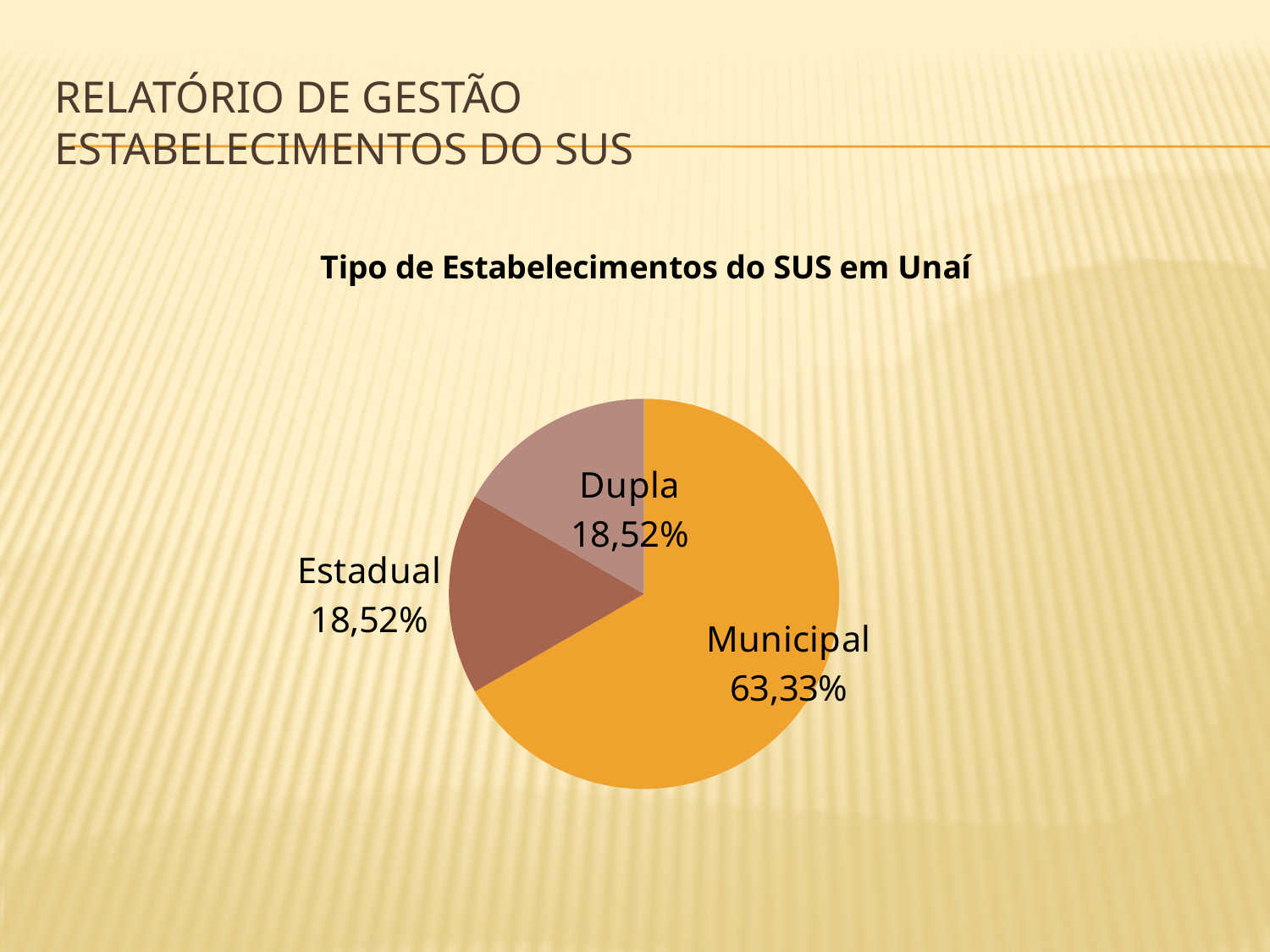
What is the value shown for Estadual? 18,52% What is the title of the chart? Tipo de Estabelecimentos do SUS em Unaí How many slices does the pie chart have? 3 What is the difference between the Municipal and Estadual shares? 44,81% Which slice of the pie is coloured orange? Municipal What is the difference between the Estadual and Dupla shares? 0% What is the value shown for Dupla? 18,52% What kind of chart is shown on the slide? Pie chart Which category has the largest slice of the pie? Municipal Which is larger, Municipal or Dupla? Municipal What share of the pie does Municipal represent? 63,33%